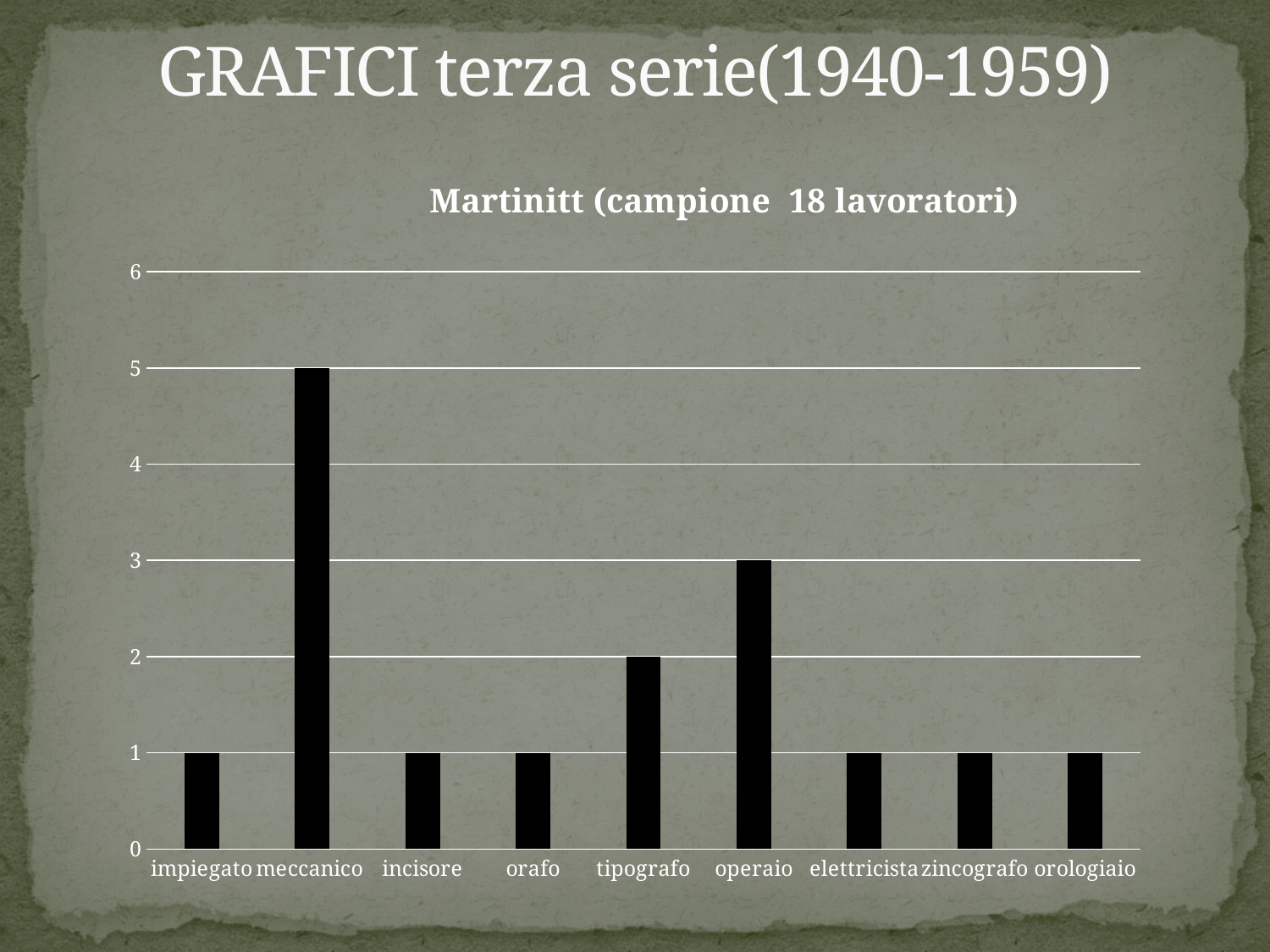
What is the value for orologiaio? 1 Which is larger, the value for tipografo or the value for operaio? operaio How many categories are shown on the x axis? 9 What is the title of the chart? Martinitt (campione 18 lavoratori) Which category has the highest value? meccanico What is the difference between the values for meccanico and operaio? 2 Is the value for meccanico greater or less than 4? greater What is the value for operaio? 3 What type of chart is shown on the slide? bar chart How many categories have a value of 1? 6 What is the value for meccanico? 5 What is the value for tipografo? 2